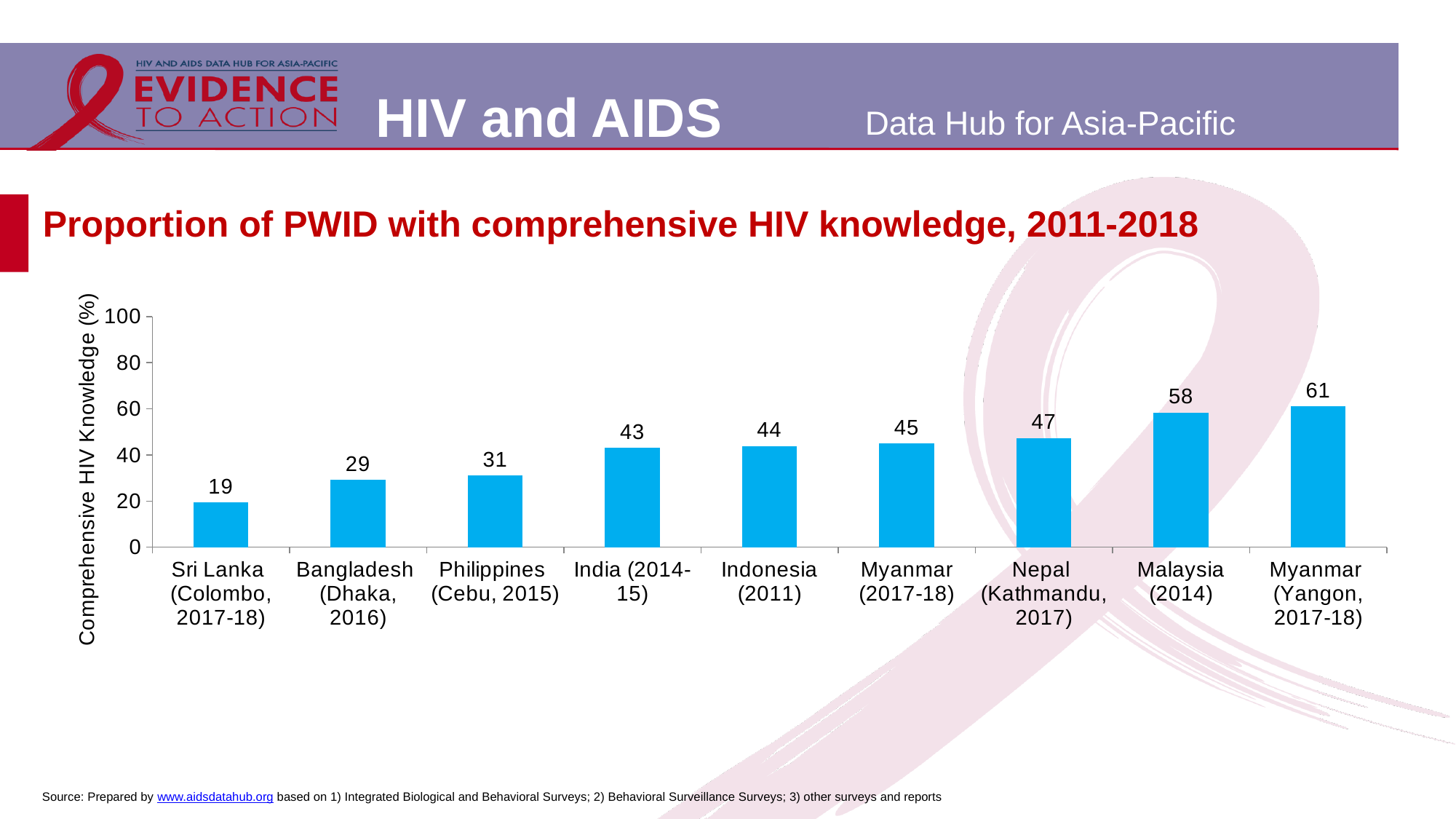
How many categories are shown on the x axis? 9 What is the label of the y axis? Comprehensive HIV Knowledge (%) Is the value for Indonesia (2011) greater or less than 60? less Which category has the lowest value? Sri Lanka (Colombo, 2017-18) What is the difference between the values for Malaysia (2014) and Bangladesh (Dhaka, 2016)? 29 What is the difference between the values for Myanmar (Yangon, 2017-18) and Sri Lanka (Colombo, 2017-18)? 42 What kind of chart is shown on the slide? bar chart Which is larger, the value for Philippines (Cebu, 2015) or the value for India (2014-15)? India (2014-15) What is the value for Sri Lanka (Colombo, 2017-18)? 19 Which category has the highest value? Myanmar (Yangon, 2017-18) What is the value for Nepal (Kathmandu, 2017)? 47 What is the value for Malaysia (2014)? 58